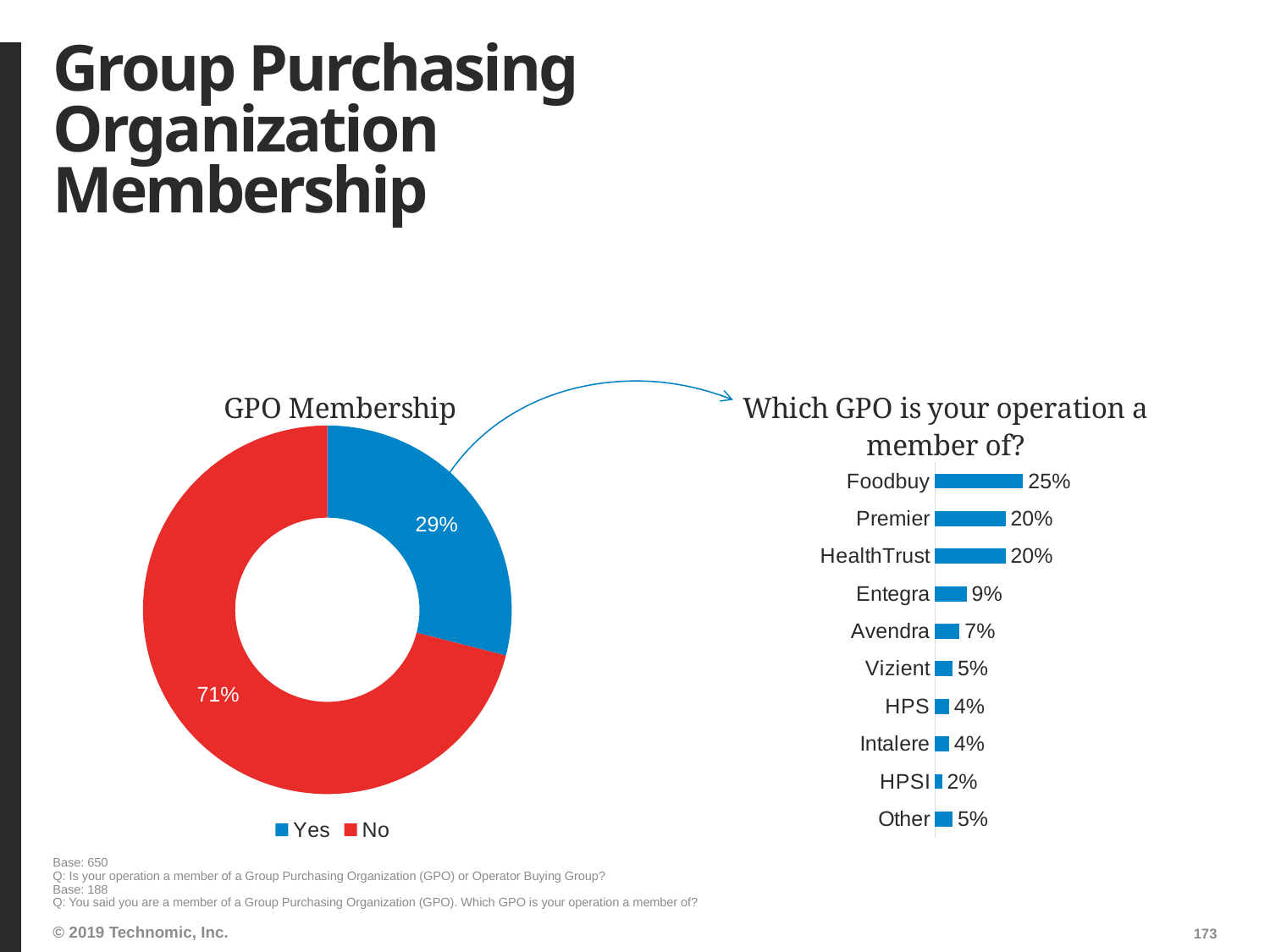
What kind of chart is the "GPO Membership" chart? Doughnut (pie) chart What kind of chart is the "Which GPO is your operation a member of?" chart? Bar chart In the "Which GPO is your operation a member of?" chart, which GPO has the highest value? Foodbuy In the "Which GPO is your operation a member of?" chart, what is the value for Entegra? 9% In the "Which GPO is your operation a member of?" chart, what is the difference between Foodbuy and Premier? 5% In the "GPO Membership" chart, what percentage answered No? 71% In the "Which GPO is your operation a member of?" chart, what is the value for Foodbuy? 25% In the "Which GPO is your operation a member of?" chart, which is larger, Avendra or Vizient? Avendra How many categories are shown in the "Which GPO is your operation a member of?" chart? 10 How many entries does the legend of the "GPO Membership" chart list? 2 In the "Which GPO is your operation a member of?" chart, which GPO has the lowest value? HPSI In the "GPO Membership" chart, what percentage answered Yes? 29%